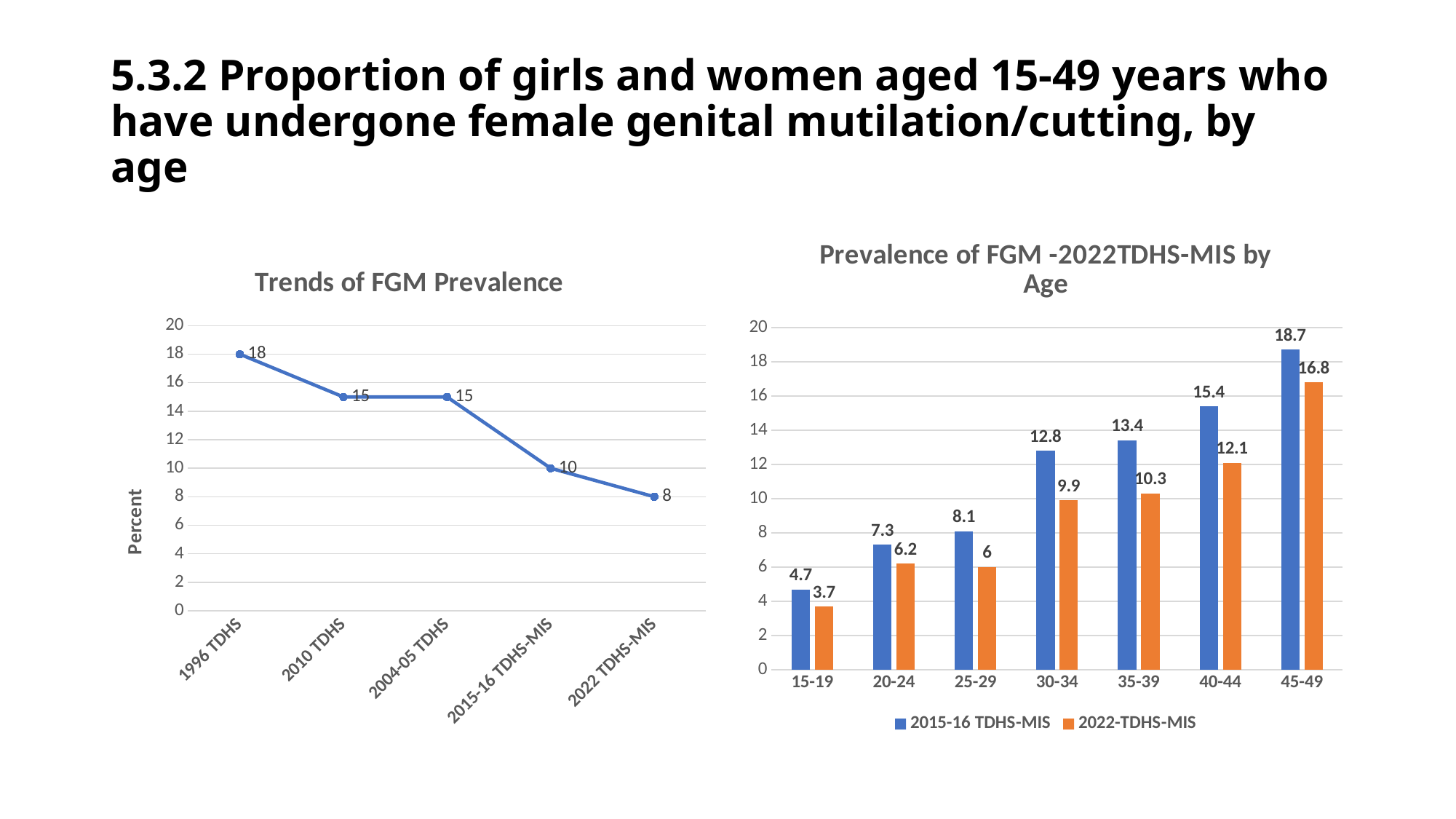
In the 'Trends of FGM Prevalence' chart, what is the value for 1996 TDHS? 18 In the 'Prevalence of FGM -2022TDHS-MIS by Age' chart, what is the 2022-TDHS-MIS value for the 30-34 age group? 9.9 In the 'Trends of FGM Prevalence' chart, do the values rise or fall from left to right along the x axis? fall In the 'Prevalence of FGM -2022TDHS-MIS by Age' chart, which is larger for the 25-29 age group: the 2015-16 TDHS-MIS value or the 2022-TDHS-MIS value? 2015-16 TDHS-MIS In the 'Prevalence of FGM -2022TDHS-MIS by Age' chart, what is the 2015-16 TDHS-MIS value for the 45-49 age group? 18.7 In the 'Prevalence of FGM -2022TDHS-MIS by Age' chart, which age group has the lowest 2022-TDHS-MIS value? 15-19 In the 'Prevalence of FGM -2022TDHS-MIS by Age' chart, how many series does the legend list? 2 In the 'Prevalence of FGM -2022TDHS-MIS by Age' chart, what is the difference between the 2015-16 TDHS-MIS and 2022-TDHS-MIS values for the 40-44 age group? 3.3 What kind of chart is 'Trends of FGM Prevalence'? line chart In the 'Trends of FGM Prevalence' chart, what is the value for 2022 TDHS-MIS? 8 In the 'Trends of FGM Prevalence' chart, how many data points are plotted? 5 In the 'Trends of FGM Prevalence' chart, what is the difference between the 1996 TDHS value and the 2022 TDHS-MIS value? 10